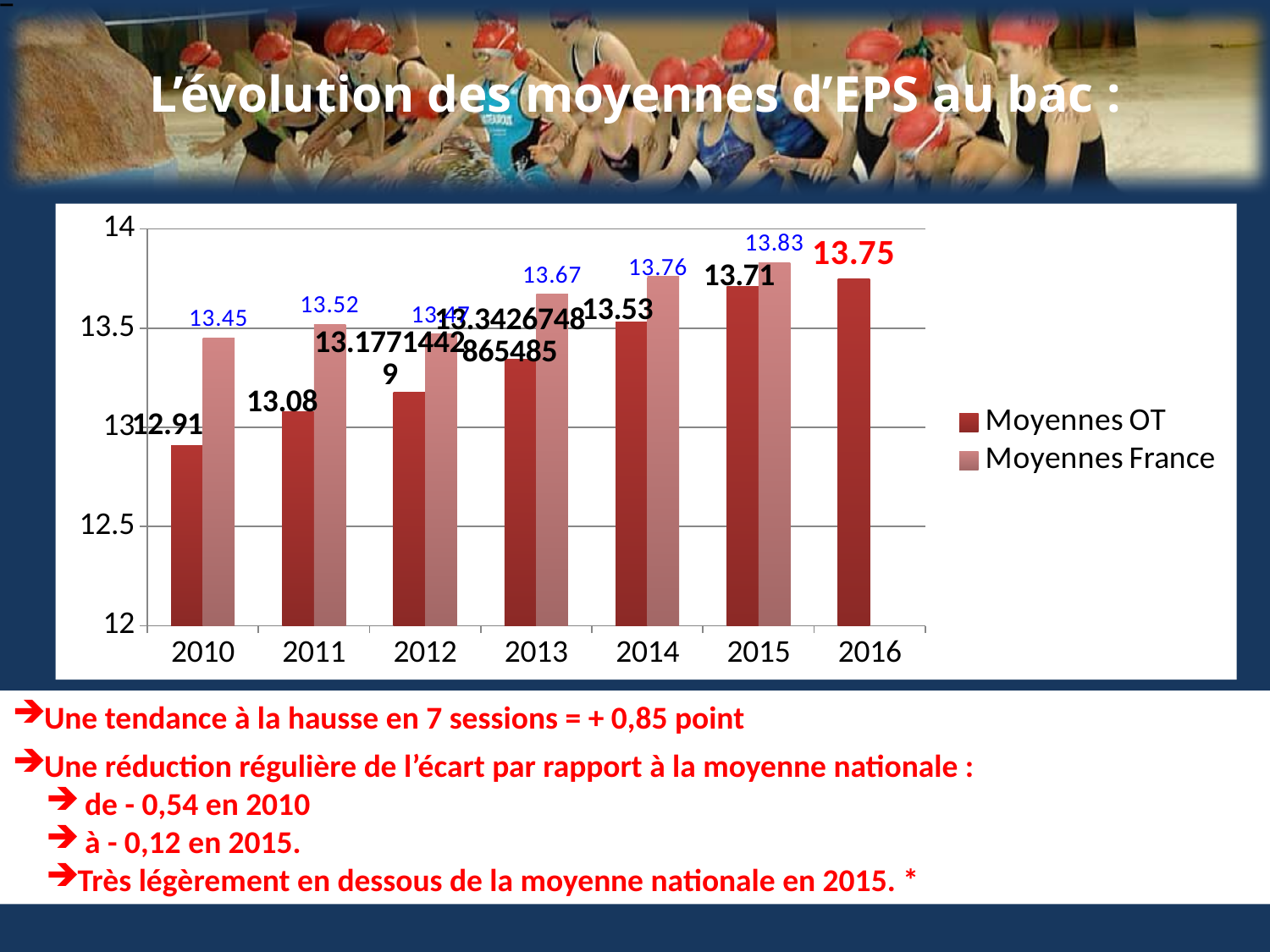
What is the value for Moyennes France in 2013? 13.67 What is the value for Moyennes OT in 2016? 13.75 In 2014, which is larger: Moyennes OT or Moyennes France? Moyennes France What is the value for Moyennes OT in 2010? 12.91 How many years are shown on the x axis of the chart? 7 In which year is the Moyennes France value the highest? 2015 What is the difference between Moyennes France and Moyennes OT in 2015? 0.12 How many series does the legend list? 2 What is the value for Moyennes France in 2015? 13.83 Is the value for Moyennes OT in 2012 greater or less than 13? greater What is the difference between Moyennes France and Moyennes OT in 2010? 0.54 In which year is the Moyennes OT value the lowest? 2010